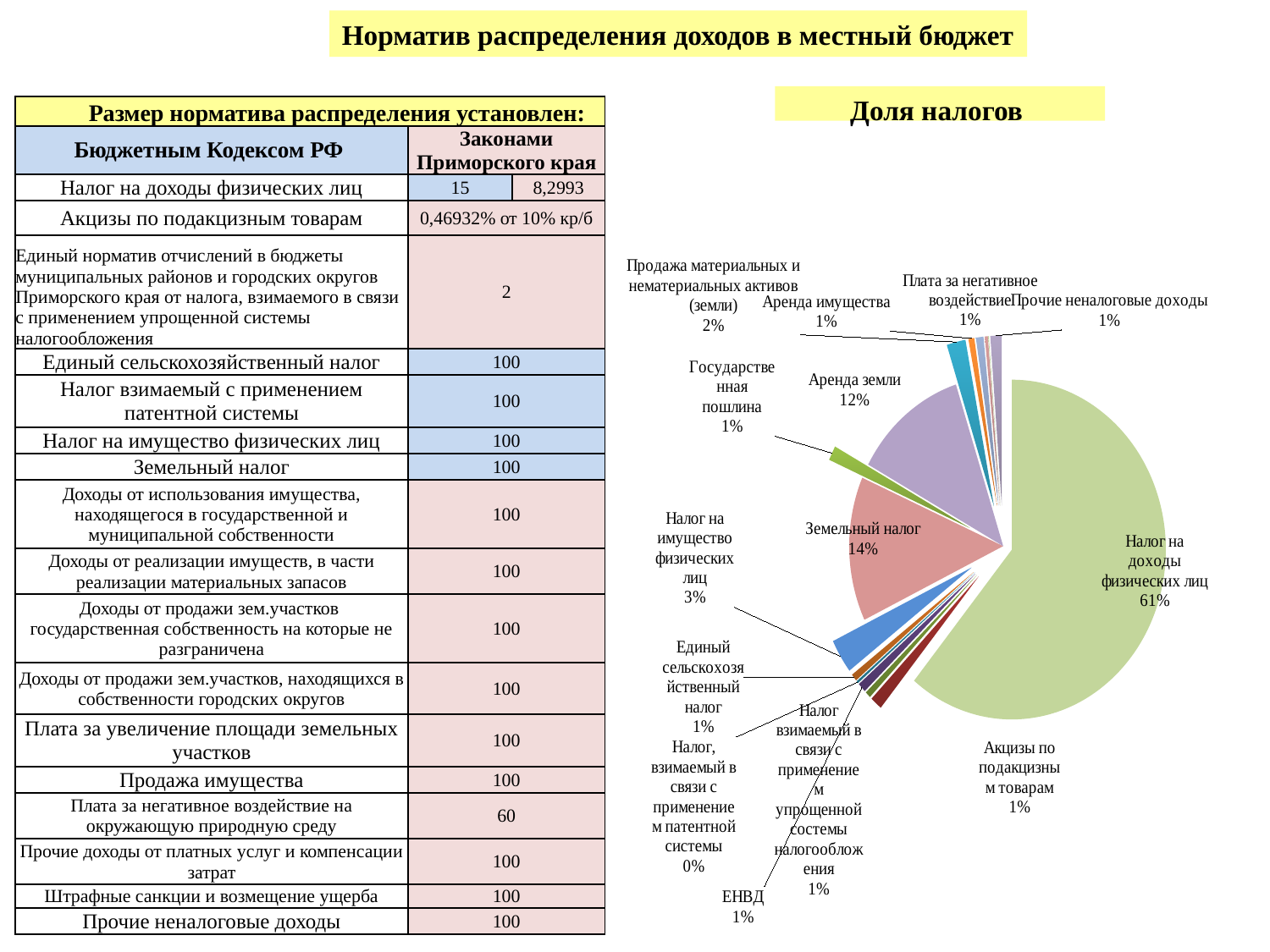
What is the title of the chart on the right side of the slide? Доля налогов What is the value shown for "Налог на имущество физических лиц" in the pie chart? 3% What is the value shown for "Аренда земли" in the pie chart? 12% Which is larger in the pie chart: "Земельный налог" or "Аренда земли"? Земельный налог Which slice of the pie chart is the largest? Налог на доходы физических лиц By how many percentage points does "Налог на доходы физических лиц" exceed "Земельный налог" in the pie chart? 47 What is the value shown for "Земельный налог" in the pie chart? 14% What is the value shown for "Продажа материальных и нематериальных активов (земли)" in the pie chart? 2% What share of the pie does "Налог на доходы физических лиц" have? 61% How many slices are labelled in the pie chart? 14 What kind of chart is shown under the title "Доля налогов"? pie chart